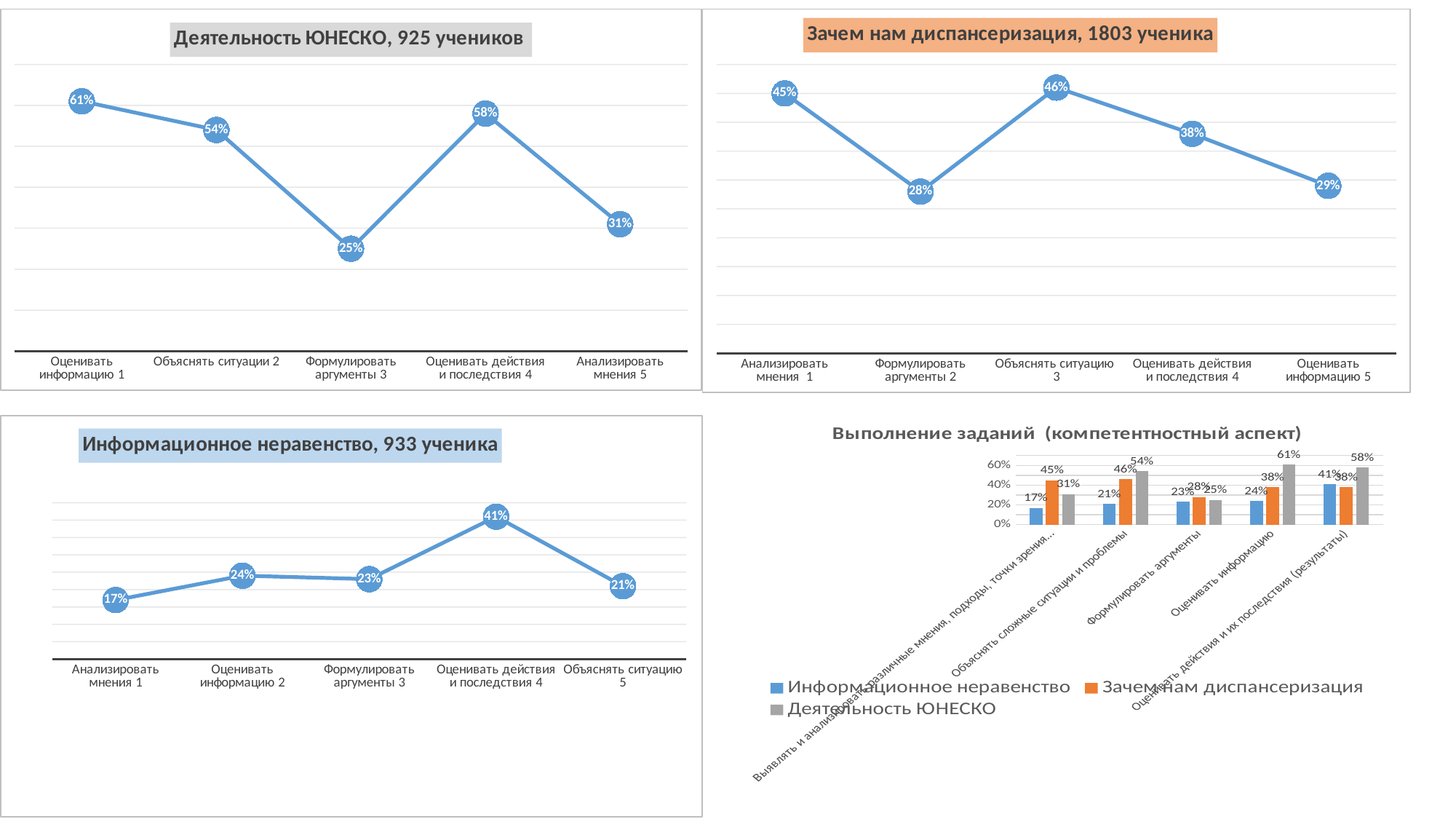
In the chart titled "Выполнение заданий (компетентностный аспект)", how many series does the legend list? 3 In the chart titled "Выполнение заданий (компетентностный аспект)", which colour represents the "Зачем нам диспансеризация" series? Orange In the chart titled "Информационное неравенство, 933 ученика", which is larger: the value for "Оценивать информацию 2" or "Объяснять ситуацию 5"? Оценивать информацию 2 In the chart titled "Деятельность ЮНЕСКО, 925 учеников", what is the value for "Формулировать аргументы 3"? 25% In the chart titled "Информационное неравенство, 933 ученика", what is the value for "Оценивать действия и последствия 4"? 41% What kind of chart is the one titled "Выполнение заданий (компетентностный аспект)"? Bar chart In the chart titled "Зачем нам диспансеризация, 1803 ученика", what is the difference between the values for "Объяснять ситуацию 3" and "Оценивать информацию 5"? 17% In the chart titled "Зачем нам диспансеризация, 1803 ученика", which category has the lowest value? Формулировать аргументы 2 In the chart titled "Деятельность ЮНЕСКО, 925 учеников", which category has the highest value? Оценивать информацию 1 In the chart titled "Зачем нам диспансеризация, 1803 ученика", what is the value for "Оценивать действия и последствия 4"? 38% In the chart titled "Выполнение заданий (компетентностный аспект)", what is the value of the "Деятельность ЮНЕСКО" series for "Оценивать информацию"? 61% In the chart titled "Информационное неравенство, 933 ученика", how many categories are plotted? 5